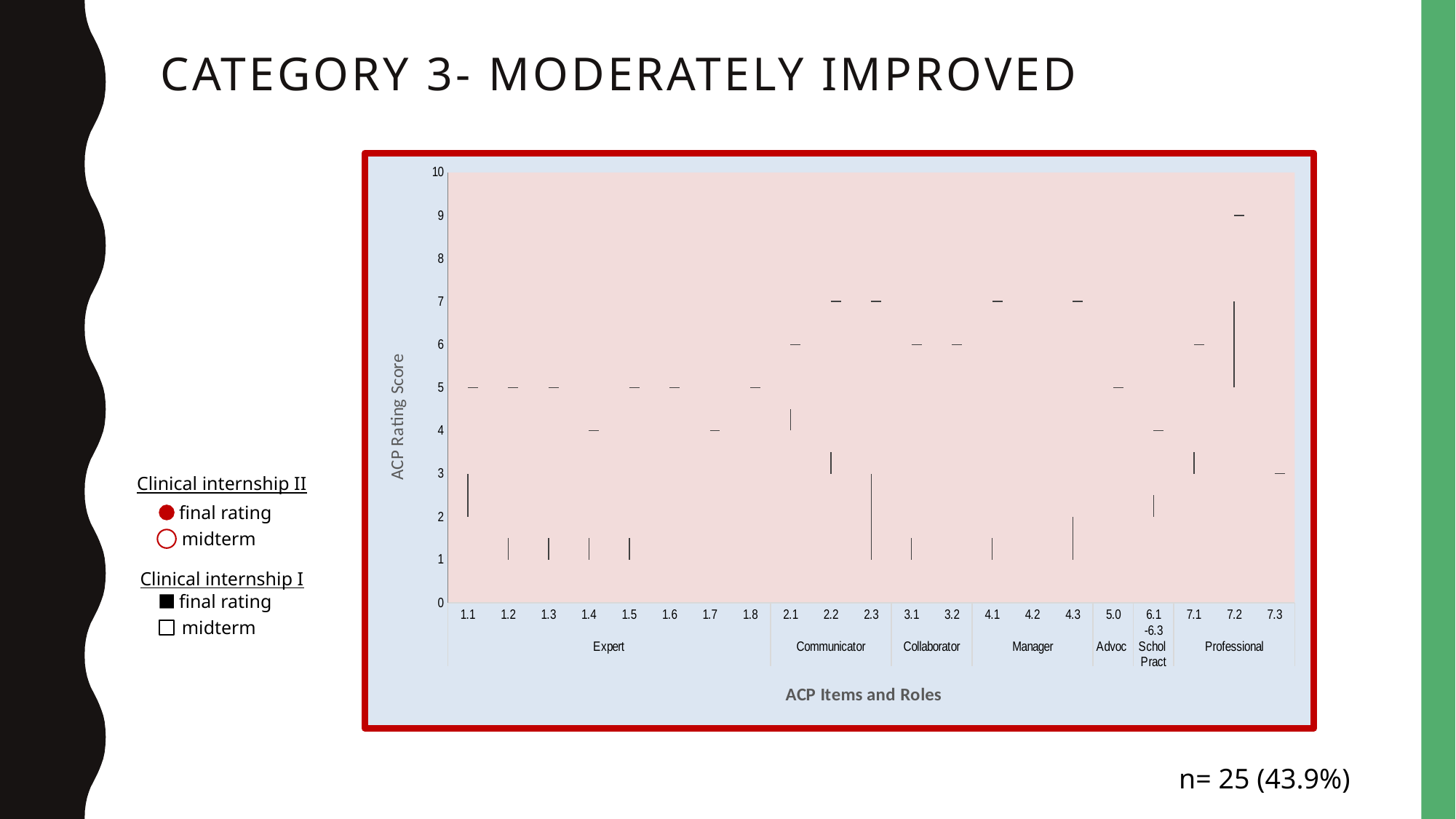
What is the title of the slide containing the chart? CATEGORY 3- MODERATELY IMPROVED Is the mark plotted for item 7.3 greater or less than 5? less Is the highest mark plotted for item 7.2 greater or less than 8? greater How many role groups (such as Expert, Communicator) are labelled along the x-axis of the chart? 7 What is the maximum value shown on the y-axis of the chart? 10 Is the mark plotted for item 1.6 greater or less than 4? greater What sample size is stated below the chart? n= 25 (43.9%) How many ACP items belong to the Expert role group on the x-axis? 8 Which ACP item has the highest mark plotted in the chart? 7.2 How many ACP items are listed along the x-axis of the chart? 21 What is the label of the y-axis of the chart? ACP Rating Score